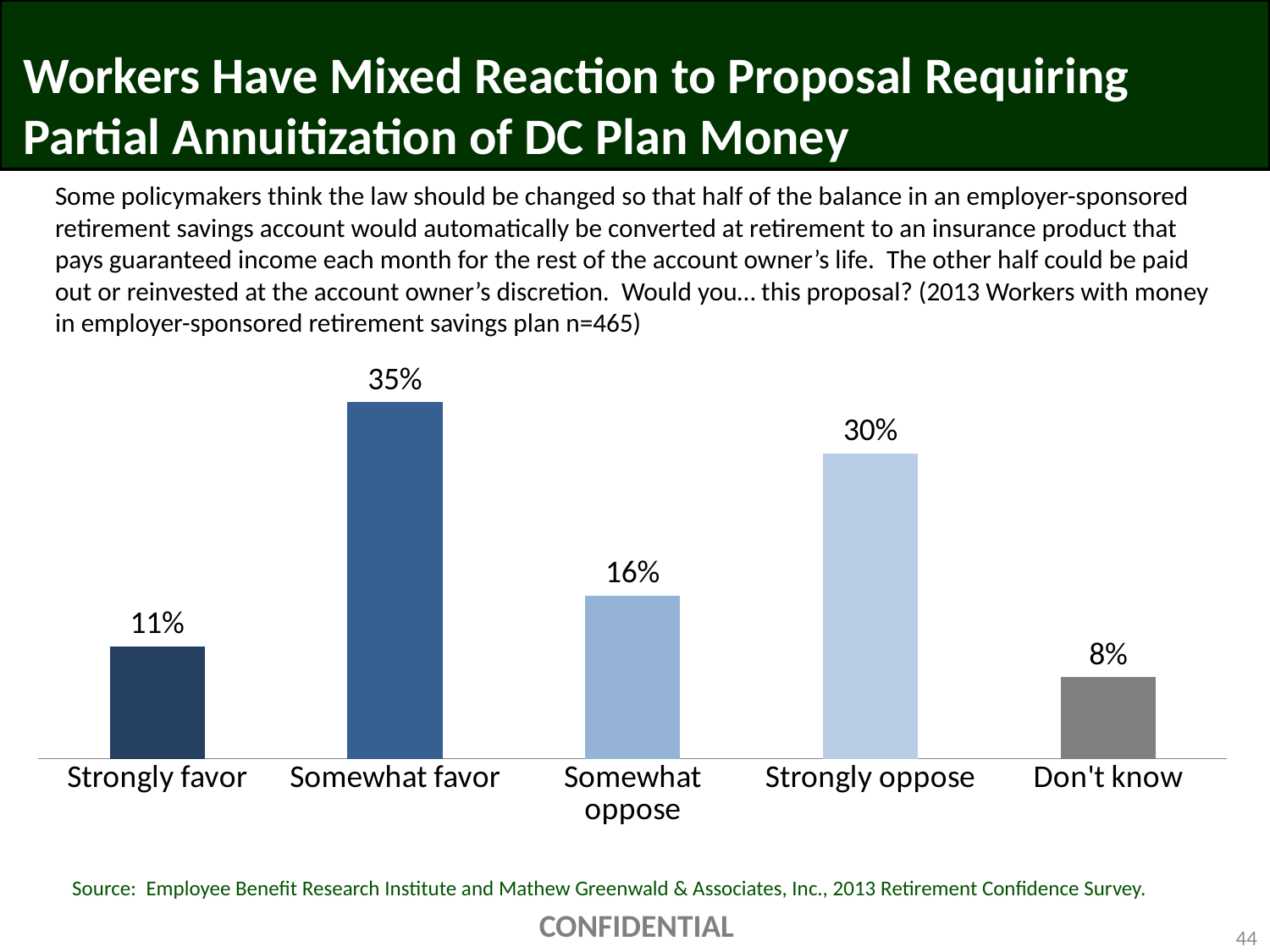
Which response category has the highest percentage? Somewhat favor What is the combined percentage of workers who strongly favor or somewhat favor the proposal? 46% How many response categories are shown in the chart? 5 Which is larger, the percentage for 'Strongly favor' or for 'Somewhat oppose'? Somewhat oppose What percentage of workers answered 'Don't know'? 8% What type of chart is shown on the slide? Bar chart What percentage of workers said they would strongly oppose the proposal? 30% What percentage of workers said they would strongly favor the proposal? 11% What percentage of workers said they would somewhat oppose the proposal? 16% What percentage of workers said they would somewhat favor the proposal? 35% What is the difference in percentage points between 'Somewhat favor' and 'Strongly oppose'? 5 percentage points Which response category has the lowest percentage? Don't know